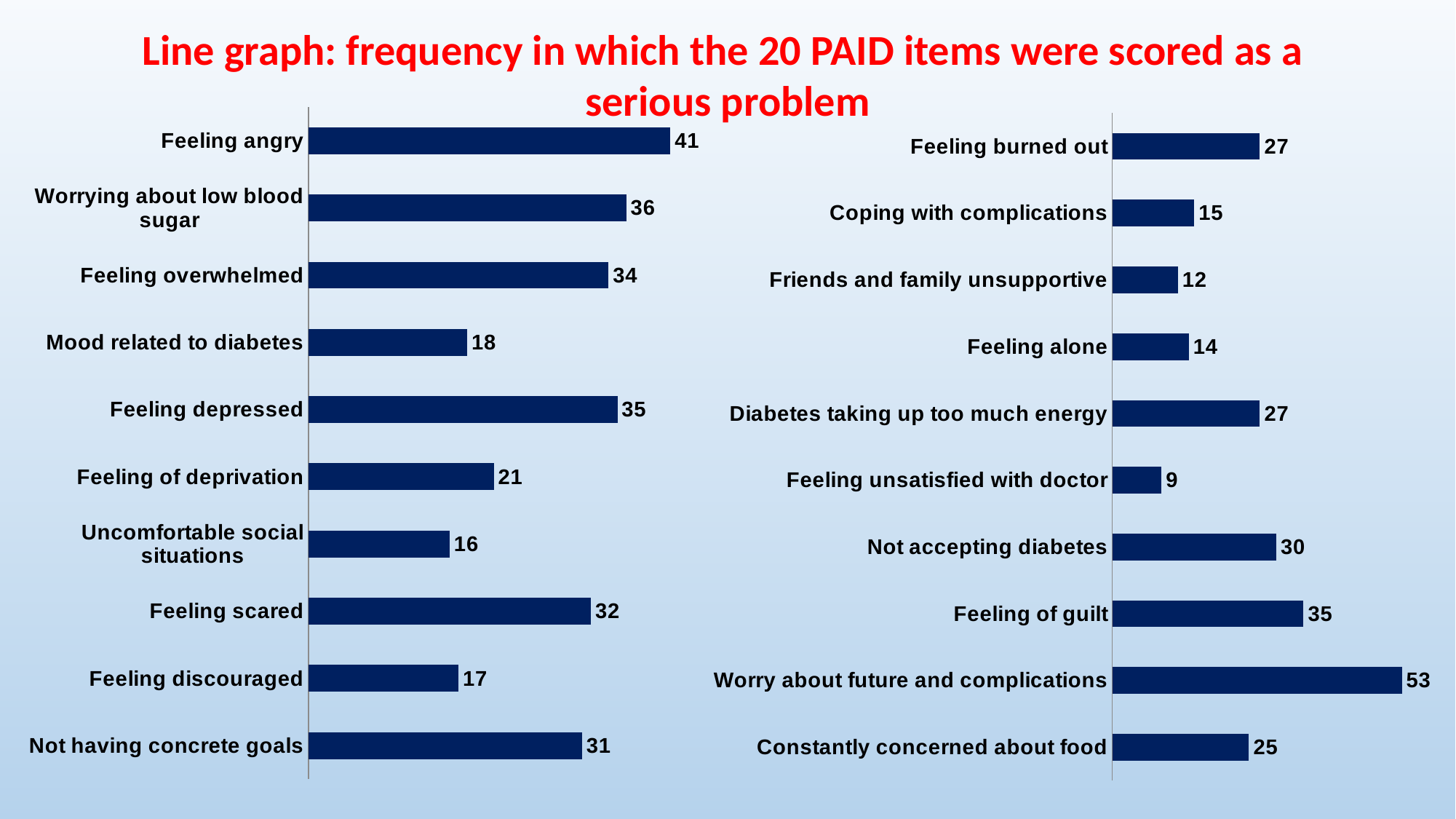
In the right chart, what is the value for Not accepting diabetes? 30 In the left chart, which category has the lowest value? Uncomfortable social situations What kind of chart is the left chart? Bar chart In the right chart, what is the difference between Worry about future and complications and Feeling of guilt? 18 In the left chart, what is the value for Feeling angry? 41 In the left chart, which category has the highest value? Feeling angry In the right chart, which category has the lowest value? Feeling unsatisfied with doctor How many categories are shown in the right chart? 10 In the left chart, what is the difference between Worrying about low blood sugar and Mood related to diabetes? 18 In the right chart, what is the value for Worry about future and complications? 53 How many categories are shown in the left chart? 10 In the left chart, which is larger: Feeling depressed or Feeling scared? Feeling depressed